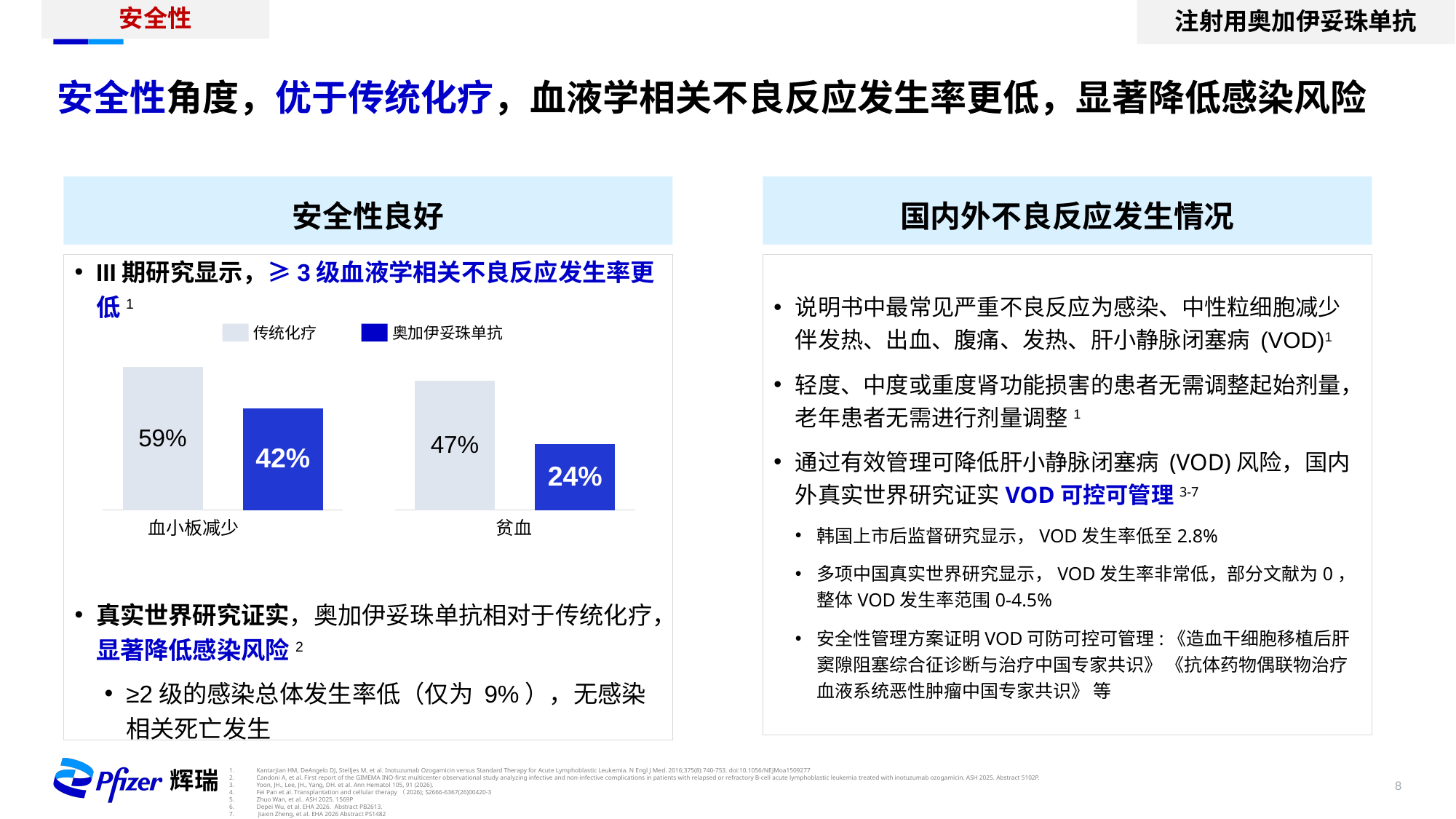
How many series does the chart legend list? 2 Which bar in the chart has the lowest value? 奥加伊妥珠单抗, 贫血 Which bar in the chart has the highest value? 传统化疗, 血小板减少 What is the value for 传统化疗 in the 贫血 category? 47% What is the difference between 传统化疗 and 奥加伊妥珠单抗 in the 贫血 category? 23% What is the value for 传统化疗 in the 血小板减少 category? 59% What is the value for 奥加伊妥珠单抗 in the 贫血 category? 24% How many categories are shown on the x axis of the chart? 2 Which is larger in the 贫血 category, 传统化疗 or 奥加伊妥珠单抗? 传统化疗 What kind of chart is shown on the slide? bar chart What is the difference between 传统化疗 and 奥加伊妥珠单抗 in the 血小板减少 category? 17% What is the value for 奥加伊妥珠单抗 in the 血小板减少 category? 42%